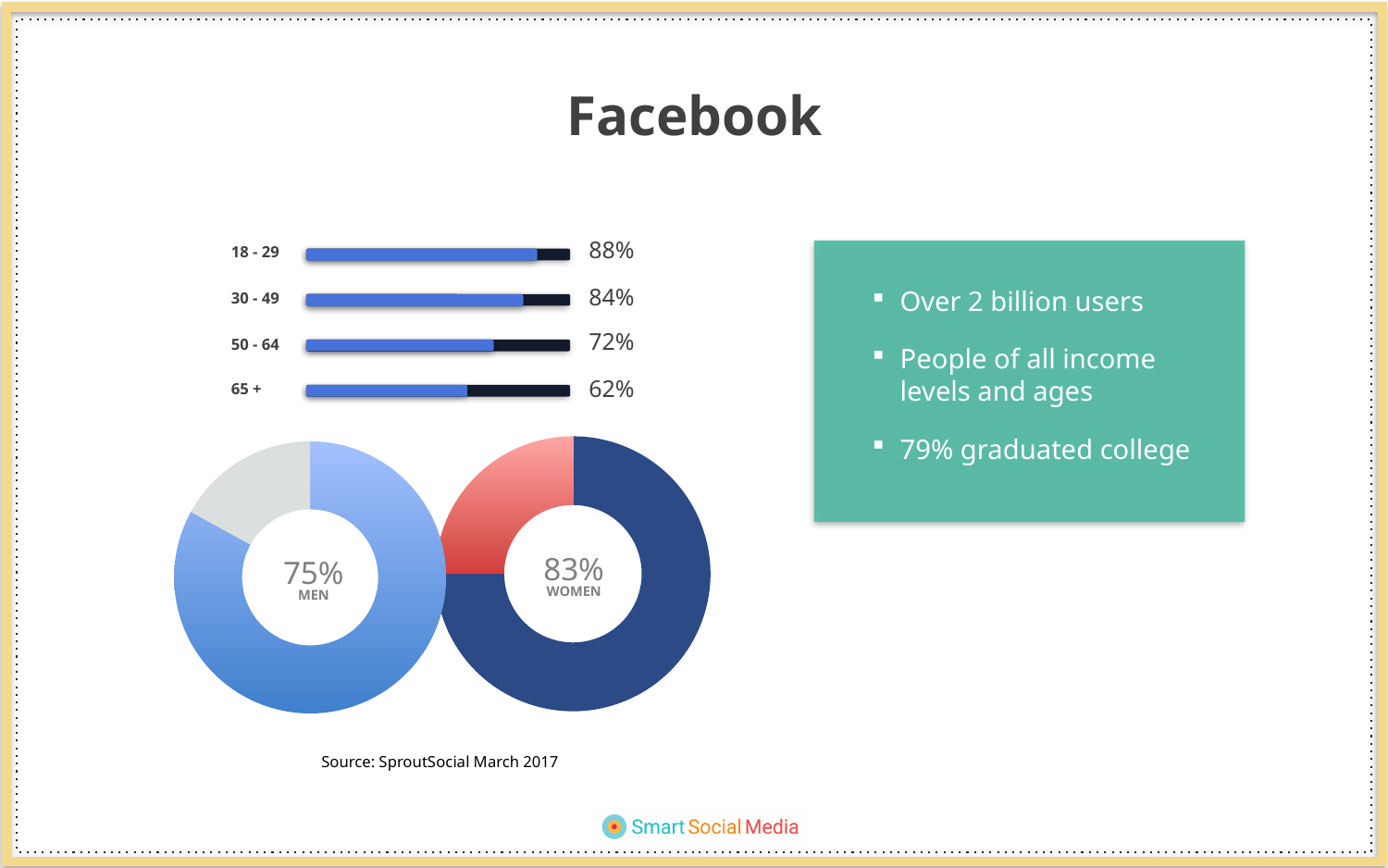
How many age groups are shown in the age-group bar chart? 4 What kind of chart is used to show the age groups at the top left of the slide? Bar chart In the age-group bar chart, which is larger, the value for 30 - 49 or the value for 50 - 64? 30 - 49 In the age-group bar chart, which age group has the highest value? 18 - 29 In the age-group bar chart, what is the difference between the 18 - 29 value and the 65 + value? 26% In the age-group bar chart, what is the value for the 50 - 64 group? 72% Which is larger, the percentage in the WOMEN donut chart or the percentage in the MEN donut chart? WOMEN In the donut chart labelled MEN, what percentage is shown? 75% In the age-group bar chart, what is the value for the 65 + group? 62% In the age-group bar chart, what is the value for the 18 - 29 group? 88% In the age-group bar chart, which age group has the lowest value? 65 + In the age-group bar chart, do the values rise or fall as the age groups get older from top to bottom? Fall